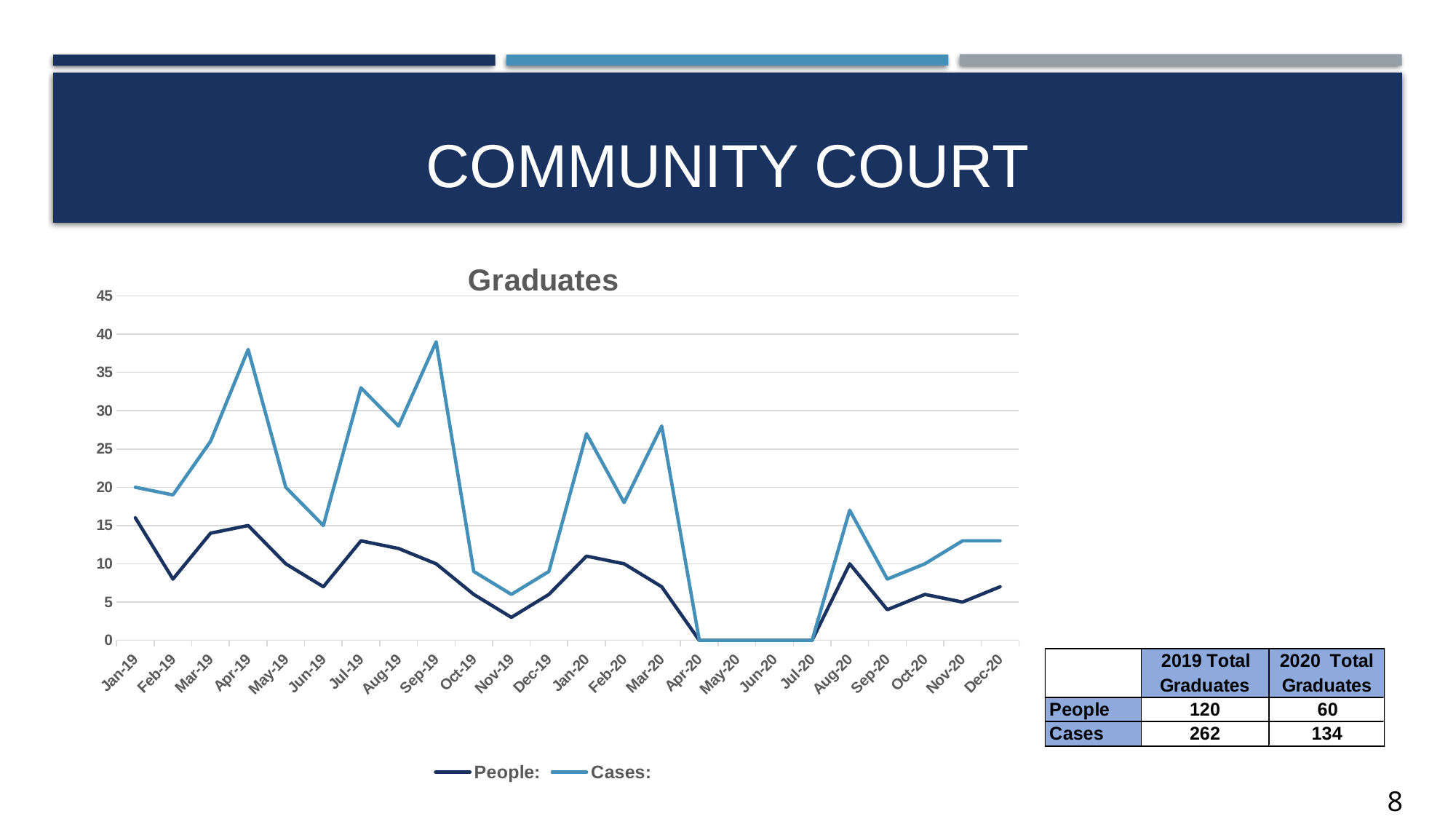
Is the value for Cases in Jul-19 greater or less than 30? greater How many series does the legend of the Graduates chart list? 2 Is the value for Cases in Apr-19 greater or less than 35? greater Do the Cases values rise or fall from Jan-19 to Apr-19 on the Graduates chart? rise What is the title of the line chart on the slide? Graduates What kind of chart is the Graduates chart? line chart What is the value for Cases in Apr-20 on the Graduates chart? 0 In Apr-19, which series has the larger value on the Graduates chart, People or Cases? Cases How many months are shown on the x axis of the Graduates chart? 24 What is the value for People in Jun-20 on the Graduates chart? 0 Is the value for People in Nov-19 greater or less than 5? less What is the value for Cases in Jan-19 on the Graduates chart? 20